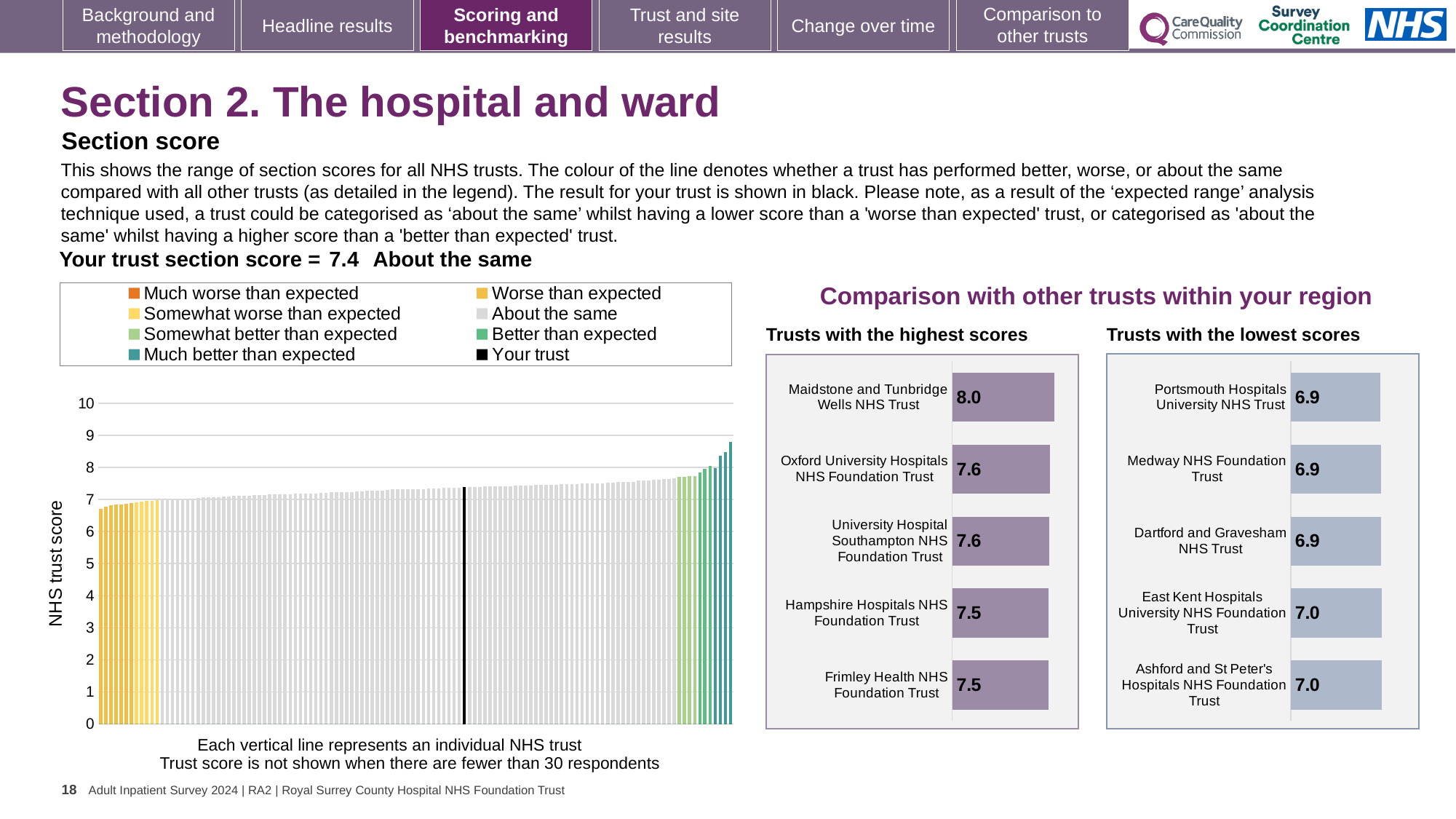
How many trusts are shown in the 'Trusts with the lowest scores' chart? 5 In the main NHS trust score chart on the left, do the trust scores rise or fall from left to right? Rise In the 'Trusts with the highest scores' chart, what is the score for Maidstone and Tunbridge Wells NHS Trust? 8.0 What type of chart is the main NHS trust score chart on the left? Bar chart In the 'Trusts with the highest scores' chart, what is the difference between the scores of Maidstone and Tunbridge Wells NHS Trust and Frimley Health NHS Foundation Trust? 0.5 In the 'Trusts with the lowest scores' chart, what is the score for East Kent Hospitals University NHS Foundation Trust? 7.0 In the 'Trusts with the highest scores' chart, which trust has the highest score? Maidstone and Tunbridge Wells NHS Trust In the 'Trusts with the highest scores' chart, which has a higher score: Maidstone and Tunbridge Wells NHS Trust or Oxford University Hospitals NHS Foundation Trust? Maidstone and Tunbridge Wells NHS Trust In the main NHS trust score chart on the left, is the value of the rightmost bar greater or less than 8? greater In the main NHS trust score chart on the left, what is the section score for your trust? 7.4 In the 'Trusts with the lowest scores' chart, what is the score for Portsmouth Hospitals University NHS Trust? 6.9 How many entries does the legend of the main NHS trust score chart list? 8